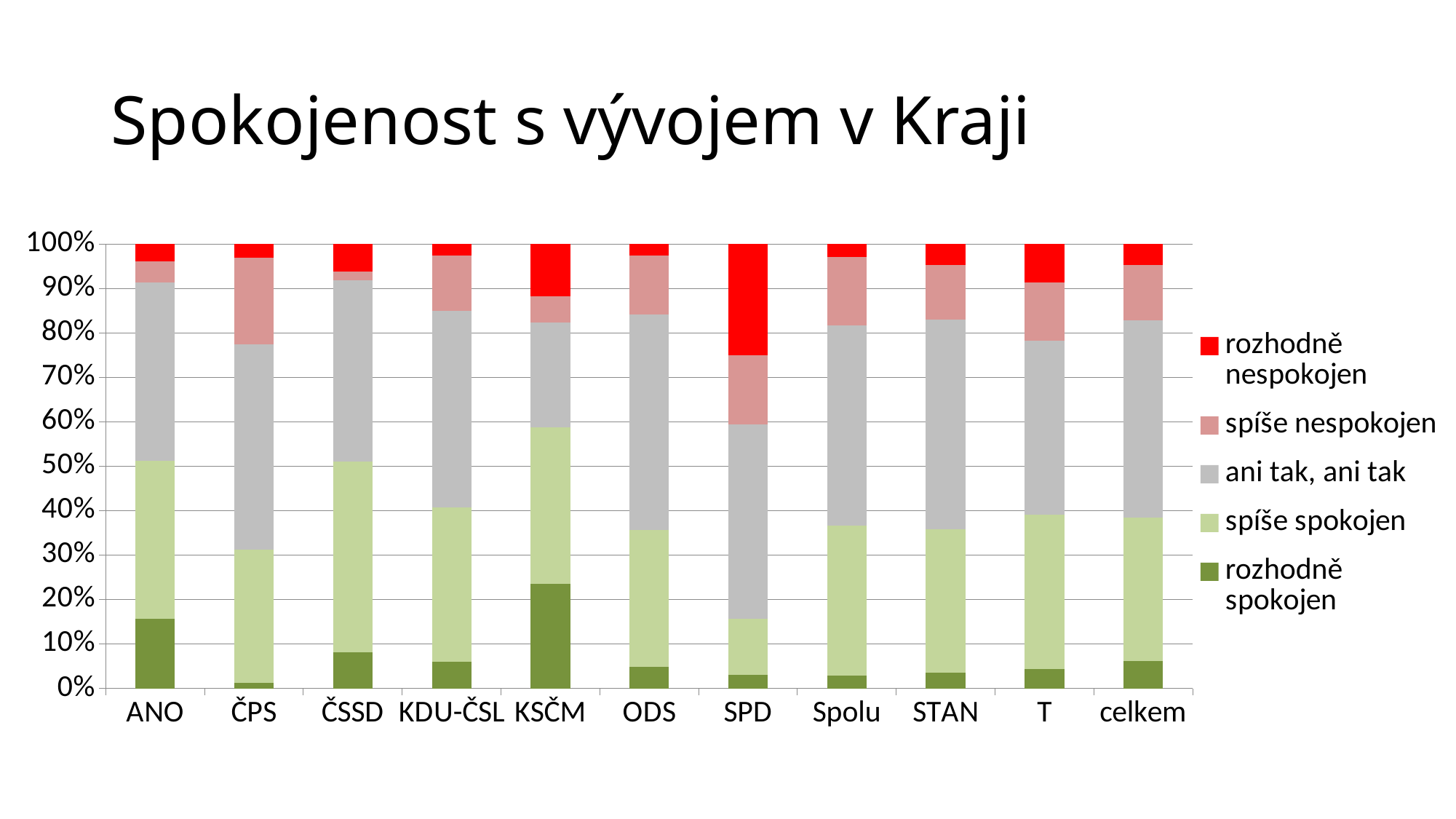
Which category has the largest 'rozhodně nespokojen' segment? SPD What is the total of each stacked bar? 100% What kind of chart is shown on the slide? stacked bar chart Is the 'rozhodně spokojen' value for KSČM greater or less than 20%? greater Which has a larger 'rozhodně spokojen' segment, ANO or ČSSD? ANO What is the title of the chart? Spokojenost s vývojem v Kraji How many series does the legend list? 5 Which series is shown in bright red? rozhodně nespokojen How many categories are shown on the x axis? 11 Which category has the largest 'rozhodně spokojen' segment? KSČM Which category has the smallest 'rozhodně spokojen' segment? ČPS Is the 'rozhodně spokojen' value for ANO greater or less than 10%? greater